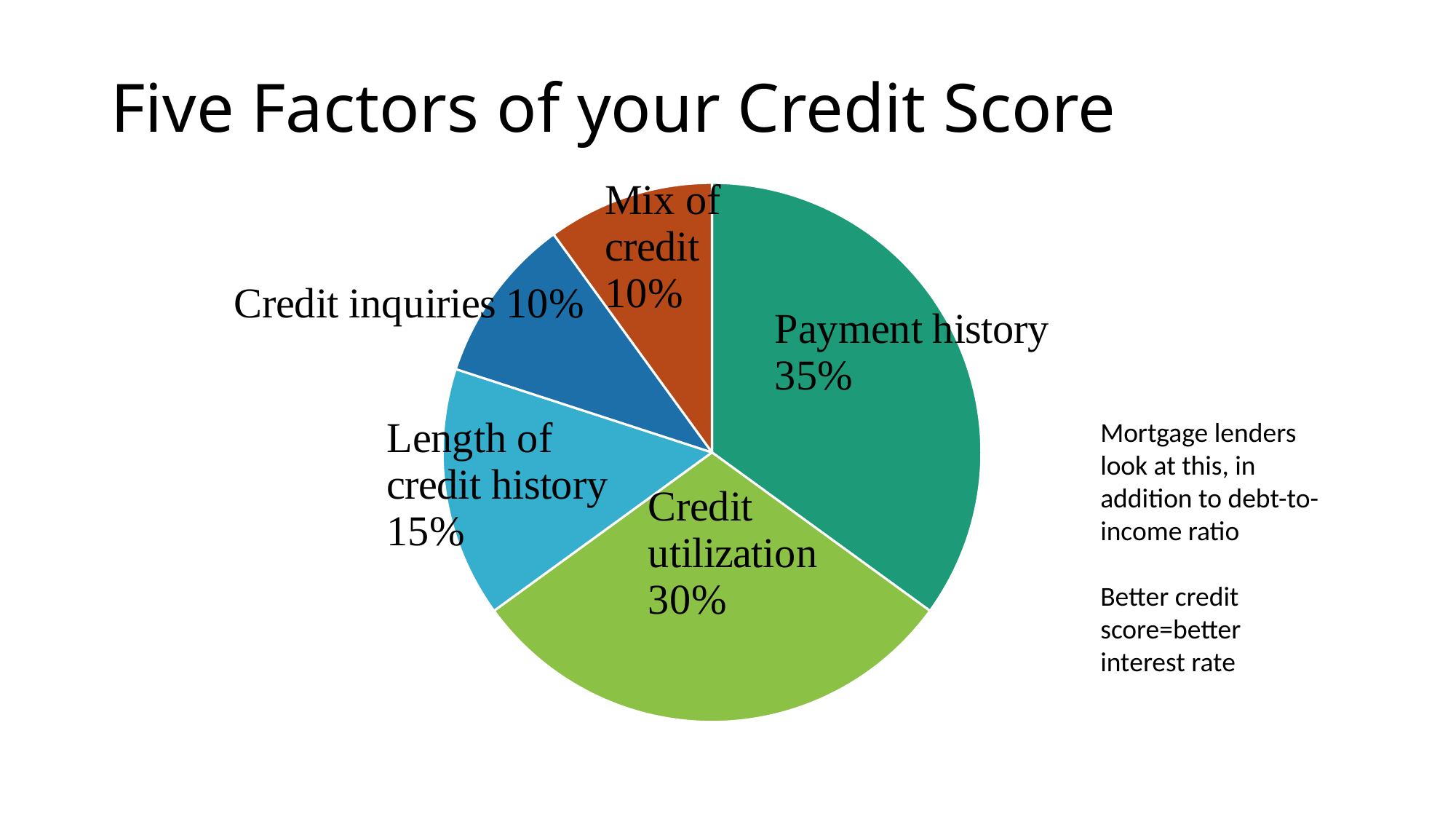
What percentage is shown for Credit utilization? 30% What percentage is shown for Mix of credit? 10% Which is larger, Length of credit history or Credit inquiries? Length of credit history What share of the credit score does Payment history account for? 35% How many slices does the pie chart have? 5 What is the title of the slide containing the chart? Five Factors of your Credit Score What kind of chart is shown on the slide? Pie chart What percentage is shown for Length of credit history? 15% What is the combined share of Payment history and Credit utilization? 65% What colour is the Credit utilization slice? Green Which factor has the largest slice of the pie? Payment history What is the difference in percentage points between Payment history and Credit utilization? 5%